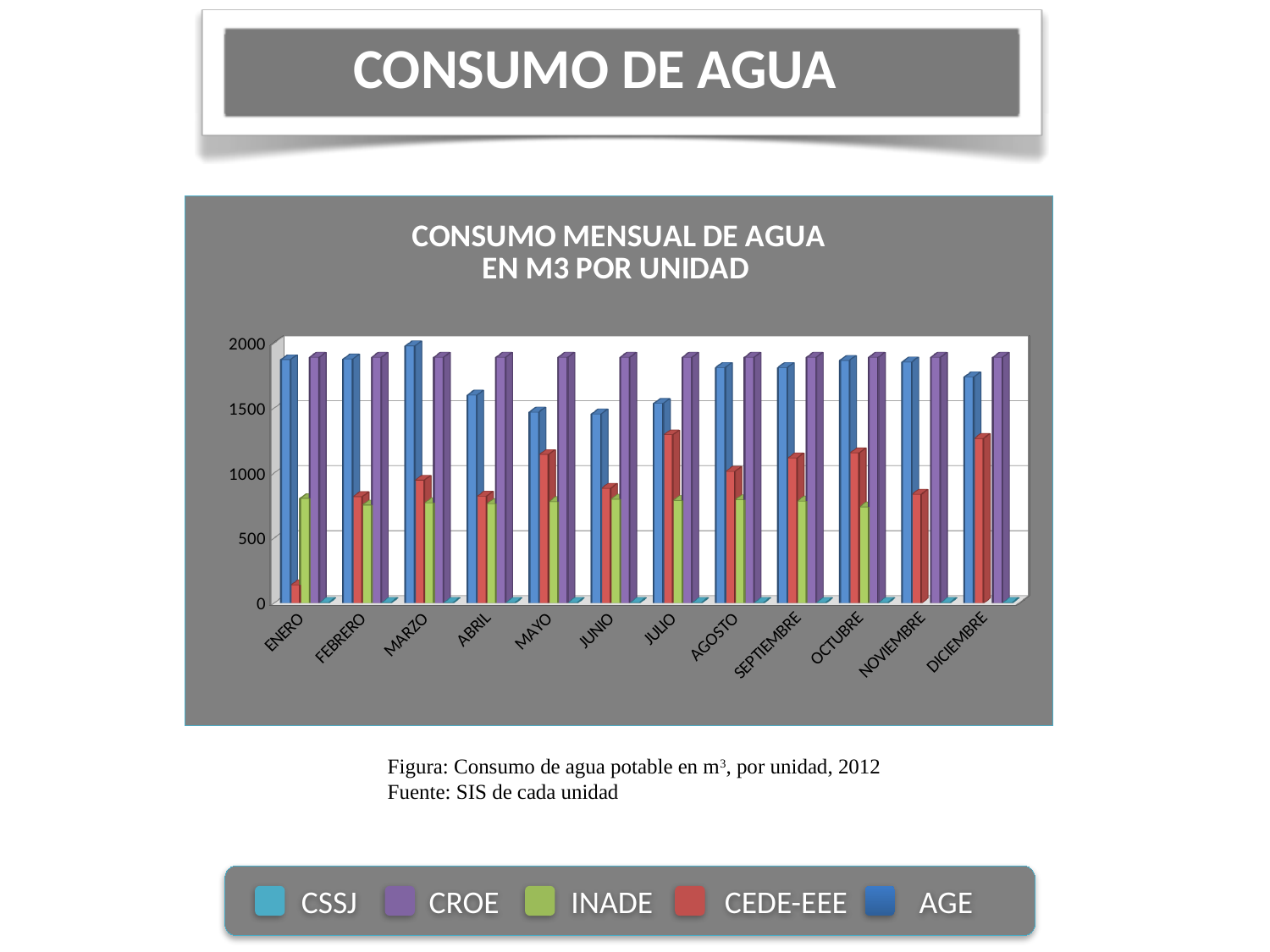
How many series does the legend list? 5 What kind of chart is shown on the slide? bar chart In which month is the CEDE-EEE value lowest? ENERO In ENERO, which is larger: the AGE value or the CEDE-EEE value? AGE Does the AGE value rise or fall from MARZO to JUNIO? fall What is the title of the chart? CONSUMO MENSUAL DE AGUA EN M3 POR UNIDAD Is the value for AGE in ENERO greater or less than 1500? greater How many months are shown on the x axis of the chart? 12 Which colour represents CROE in the chart? purple In which month is the AGE value highest? MARZO Is the value for CEDE-EEE in JULIO greater or less than 1000? greater Is the value for CEDE-EEE in ENERO greater or less than 500? less